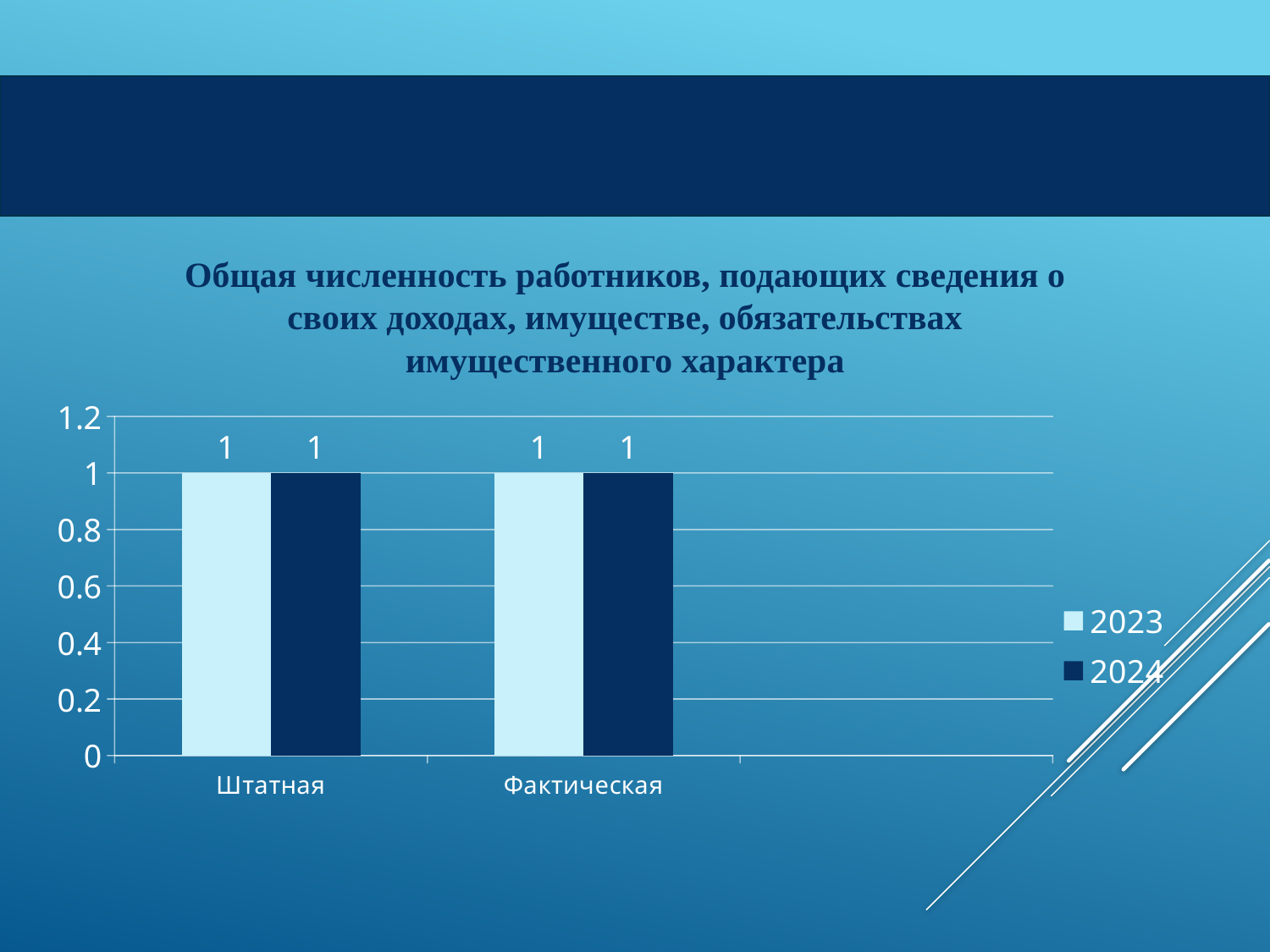
How many series does the legend list? 2 What is the value for Фактическая in the 2024 series? 1 What is the value for Фактическая in the 2023 series? 1 What is the difference between the 2023 and 2024 values for Штатная? 0 What is the value for Штатная in the 2023 series? 1 What kind of chart is shown on the slide? bar chart Is the value for Фактическая in 2023 greater or less than 0.8? greater What is the value for Штатная in the 2024 series? 1 How many categories are shown on the x axis? 2 What is the highest value shown on the y axis? 1.2 Which series is shown in dark blue in the legend? 2024 Do the 2024 values rise, fall or stay the same from Штатная to Фактическая? stay the same